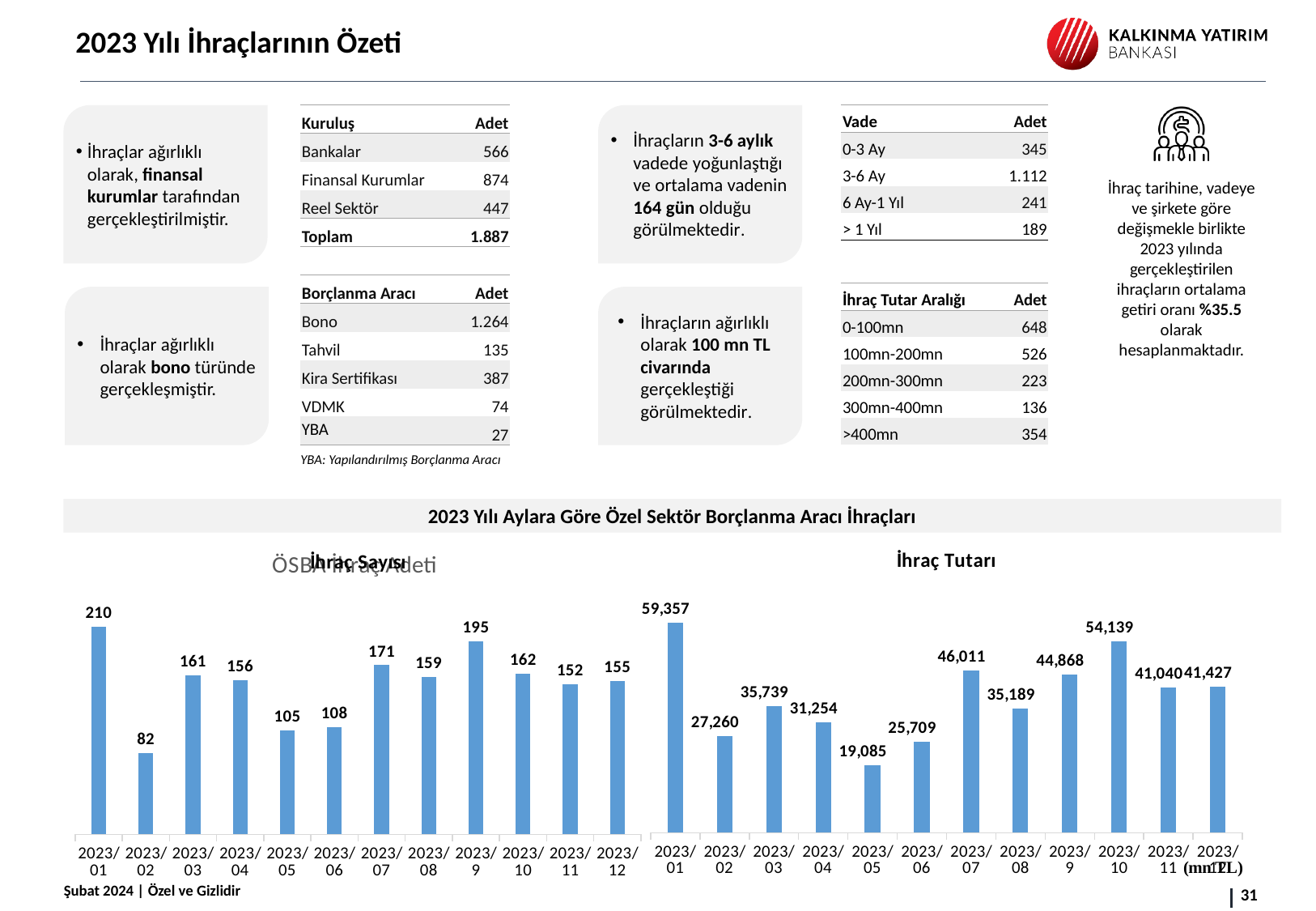
What kind of chart is the İhraç Tutarı chart? Bar chart In the left chart (İhraç Sayısı), what is the difference between the values for 2023/9 and 2023/05? 90 In the left chart (İhraç Sayısı), which month has the highest value? 2023/01 In the İhraç Tutarı chart, what is the value for 2023/10? 54,139 In the İhraç Tutarı chart, what is the difference between the values for 2023/01 and 2023/02? 32,097 In the İhraç Tutarı chart, which month has the lowest value? 2023/05 In the İhraç Tutarı chart, which is larger, the value for 2023/07 or the value for 2023/9? 2023/07 In the İhraç Tutarı chart, which month has the highest value? 2023/01 In the left chart (İhraç Sayısı), what is the value for 2023/01? 210 What is the title of the section containing the two charts at the bottom of the slide? 2023 Yılı Aylara Göre Özel Sektör Borçlanma Aracı İhraçları In the left chart (İhraç Sayısı), how many months are plotted? 12 In the left chart (İhraç Sayısı), which month has the lowest value? 2023/02